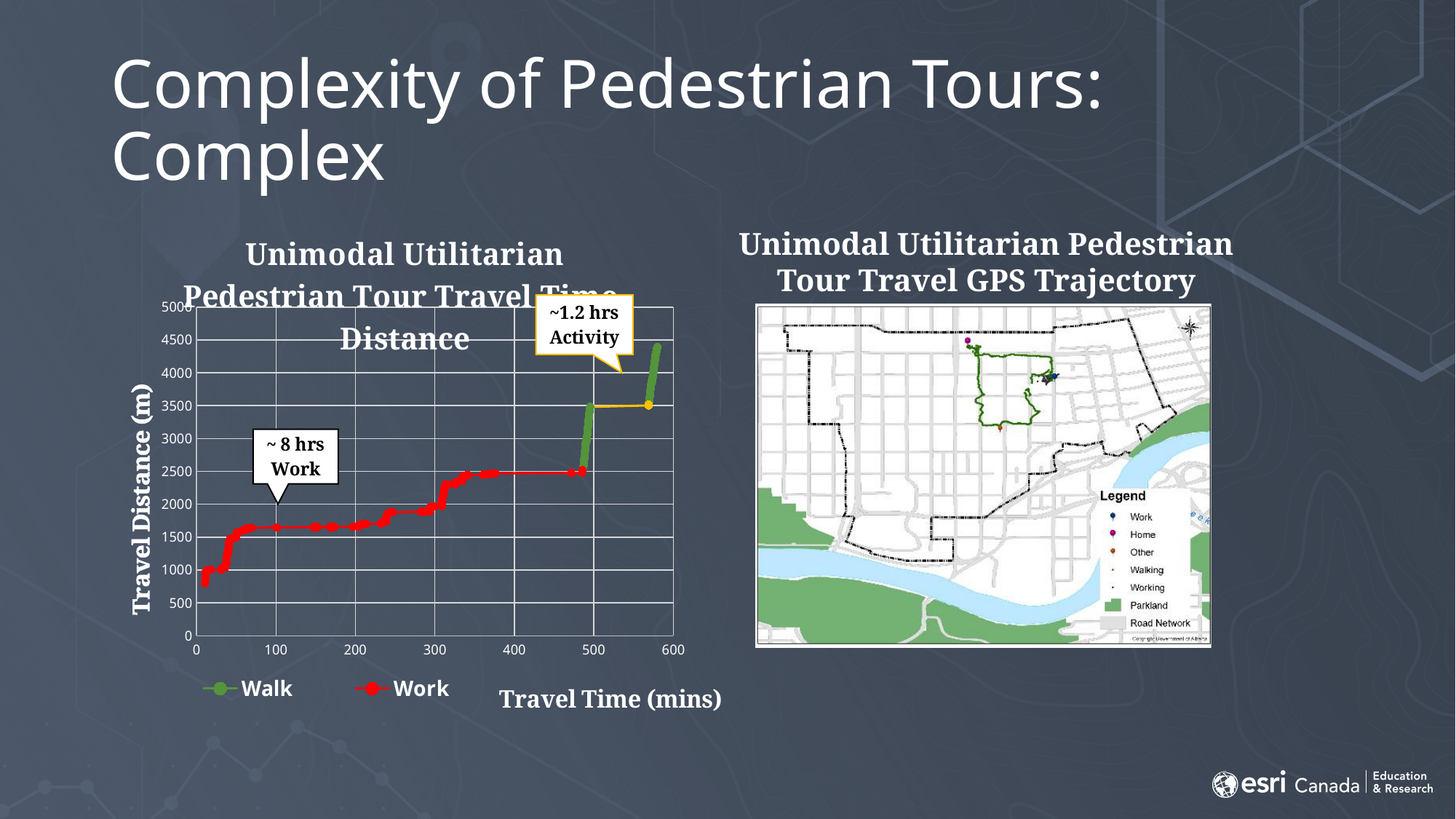
On the Travel Time Distance chart, is the travel distance at 100 mins greater or less than 1500? greater On the Travel Time Distance chart, is the travel distance at 200 mins greater or less than 2000? less What are the two series named in the legend of the Travel Time Distance chart? Walk and Work What kind of chart is the Unimodal Utilitarian Pedestrian Tour Travel Time Distance chart? line chart On the Travel Time Distance chart, is the travel distance at 450 mins greater or less than 2000? greater On the Travel Time Distance chart, does travel distance rise or fall as travel time increases? rise How many series does the legend of the Travel Time Distance chart list? 2 What is the label of the x axis on the Travel Time Distance chart? Travel Time (mins) What is the highest tick value shown on the y axis of the Travel Time Distance chart? 5000 What is the highest tick value shown on the x axis of the Travel Time Distance chart? 600